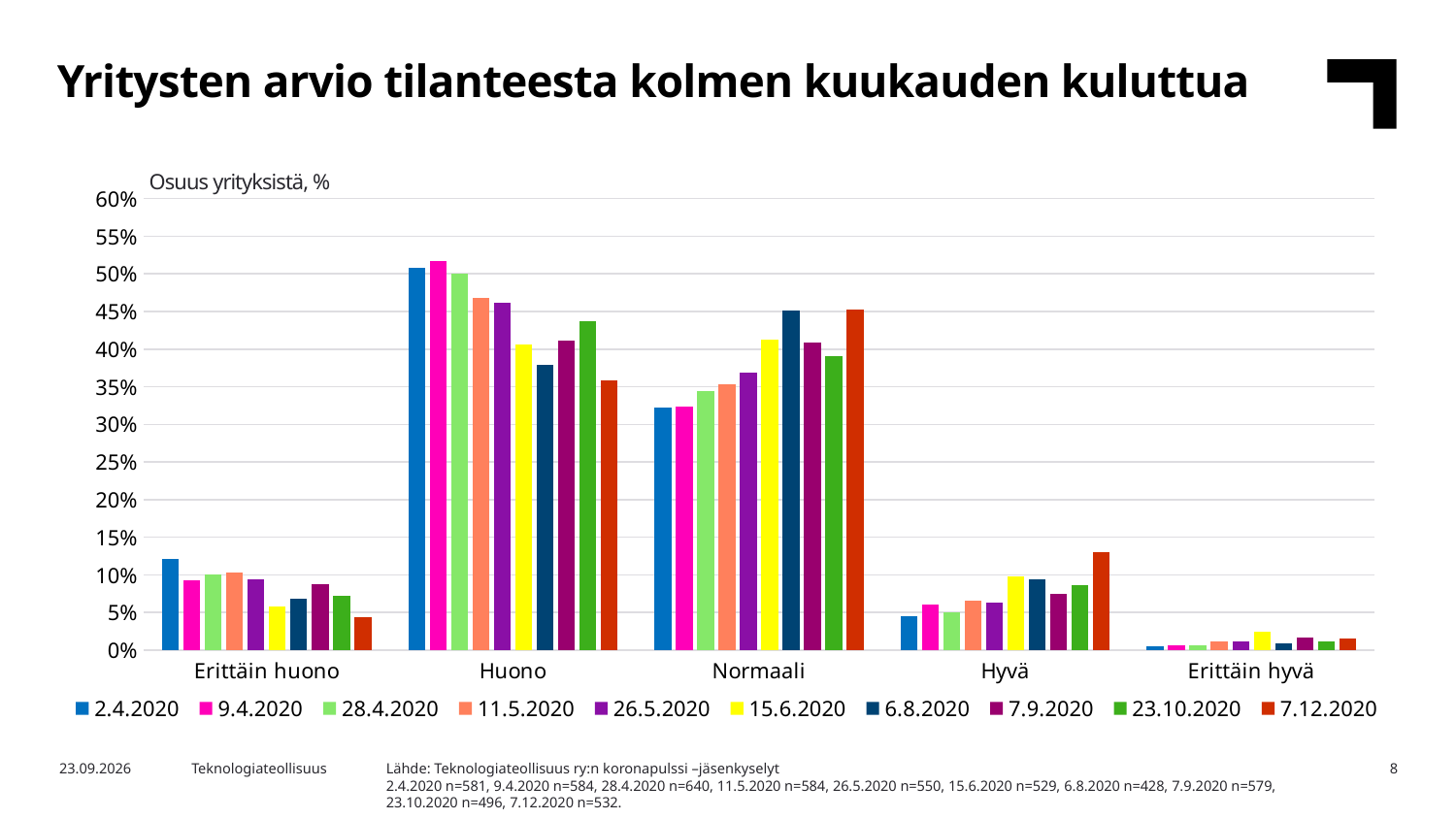
How many series does the legend list? 10 For Hyvä, which is larger: the value for 2.4.2020 or the value for 7.12.2020? 7.12.2020 What is the label shown above the vertical axis of the chart? Osuus yrityksistä, % Is the value for Hyvä on 7.12.2020 greater or less than 10%? greater Within the Hyvä category, which survey date has the highest value? 7.12.2020 Which category has the lowest bars overall? Erittäin hyvä Is the value for Normaali on 7.12.2020 greater or less than 40%? greater Which category contains the tallest bar in the chart? Huono How many categories are shown on the x axis of the chart? 5 What type of chart is shown on the slide? bar chart Is the value for Erittäin huono on 2.4.2020 greater or less than 10%? greater